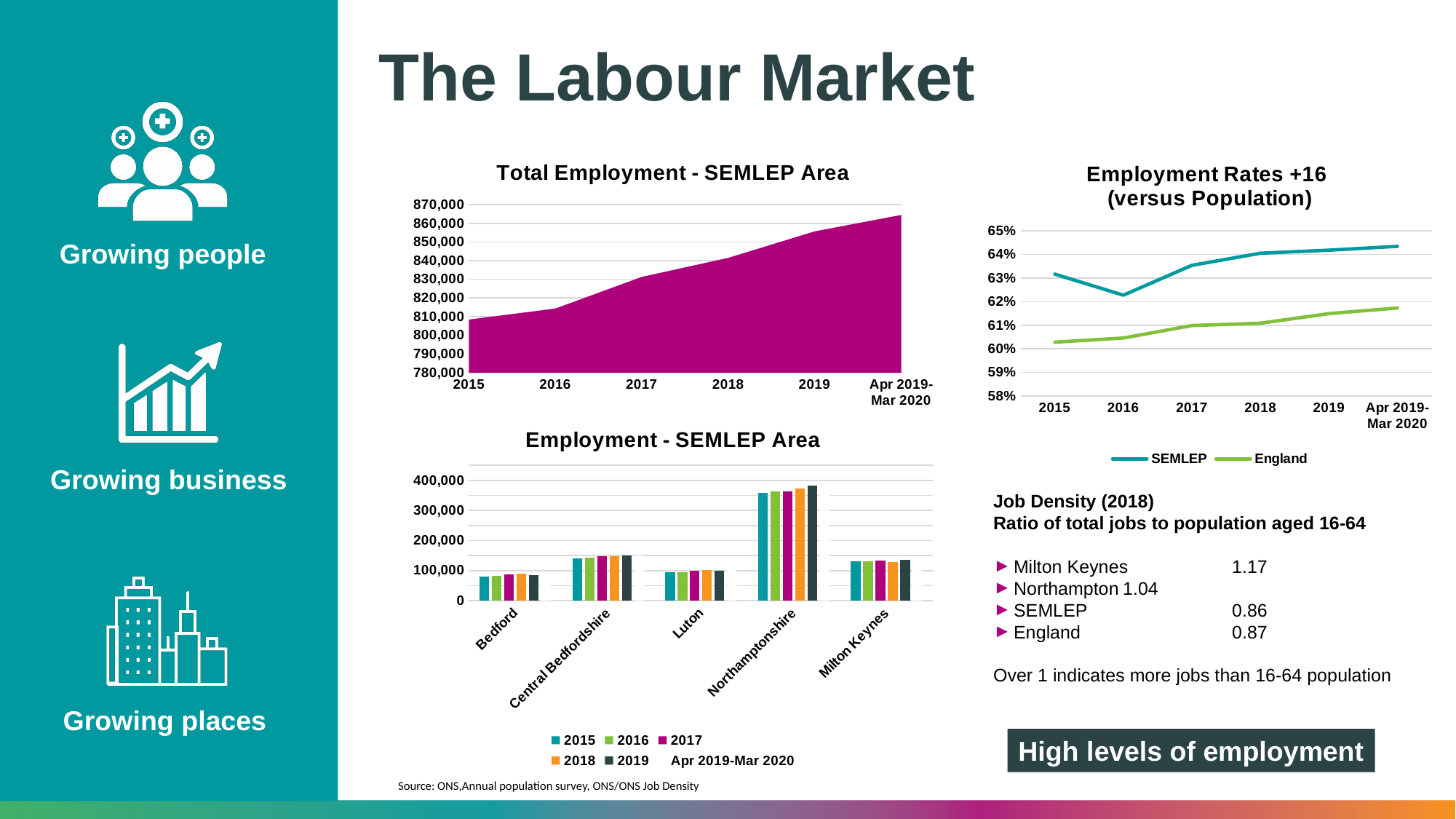
What kind of chart is the 'Employment - SEMLEP Area' chart? Bar chart In the 'Total Employment - SEMLEP Area' chart, is the value for 2016 greater or less than 820,000? less How many categories are shown on the x axis of the 'Employment - SEMLEP Area' chart? 5 What kind of chart is the 'Total Employment - SEMLEP Area' chart? Area chart In the 'Employment - SEMLEP Area' chart, is the 2019 value for Northamptonshire greater or less than 300,000? greater In the 'Employment Rates +16 (versus Population)' chart, in which year is the SEMLEP line at its lowest? 2016 In the 'Employment Rates +16 (versus Population)' chart, which series has the higher values throughout, SEMLEP or England? SEMLEP In the 'Employment - SEMLEP Area' chart, which category has the highest employment? Northamptonshire In the 'Total Employment - SEMLEP Area' chart, is the value for 2019 greater or less than 850,000? greater In the 'Total Employment - SEMLEP Area' chart, do the values rise or fall from 2015 to Apr 2019-Mar 2020? Rise How many series does the legend of the 'Employment Rates +16 (versus Population)' chart list? 2